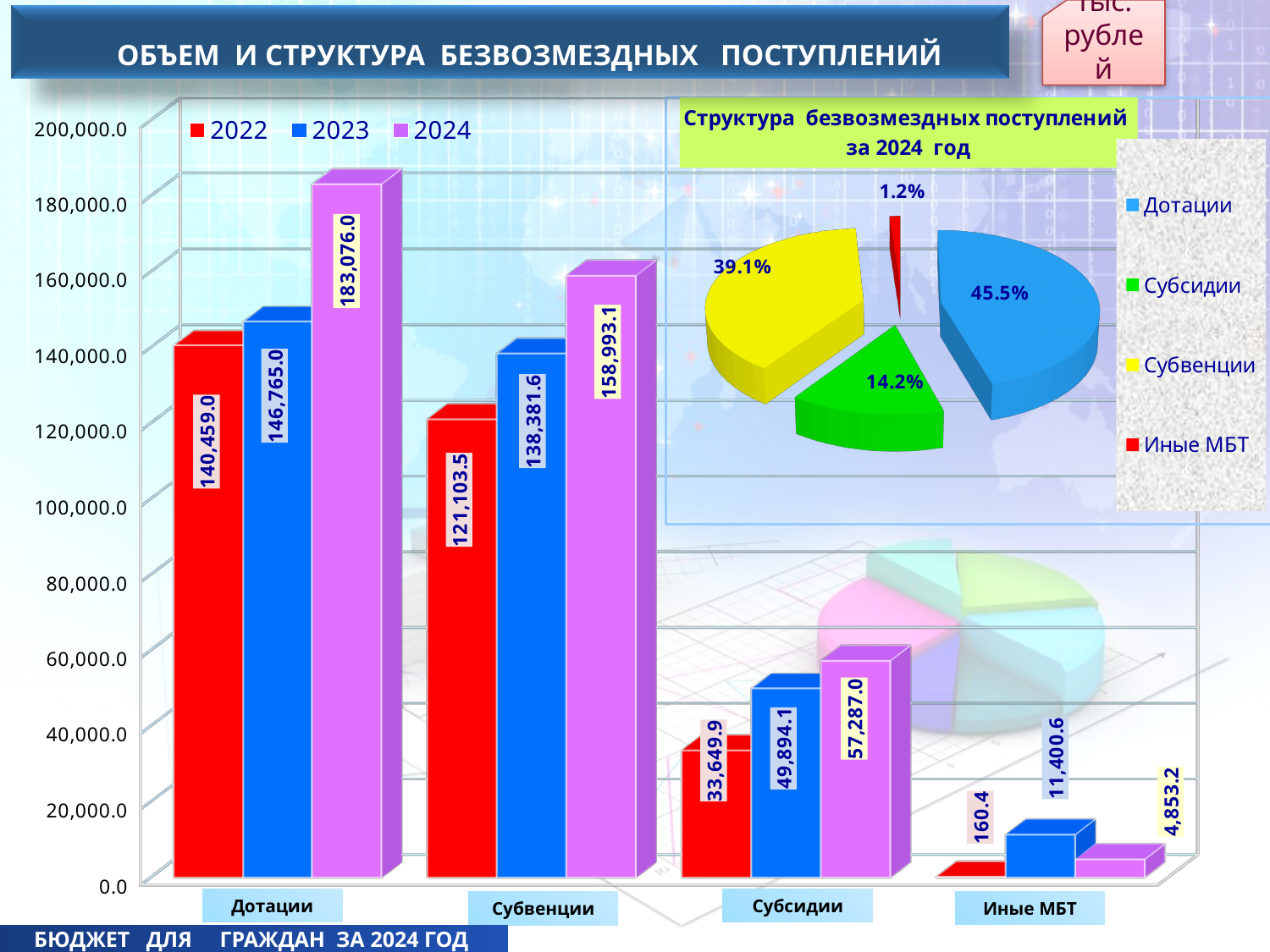
In the bar chart, which category has the lowest value in 2022? Иные МБТ In the bar chart, how many categories are shown on the x axis? 4 In the bar chart, what is the value for Иные МБТ in 2023? 11,400.6 In the bar chart, how many series does the legend list? 3 In the bar chart, what is the difference between the 2024 and 2023 values for Субсидии? 7,392.9 In the bar chart, do the values for Субвенции rise or fall from 2022 to 2024? rise In the pie chart 'Структура безвозмездных поступлений за 2024 год', which slice is the largest? Дотации In the bar chart, which category has the highest value in 2024? Дотации In the bar chart, what is the value for Дотации in 2024? 183,076.0 In the bar chart, what is the value for Субвенции in 2022? 121,103.5 In the pie chart 'Структура безвозмездных поступлений за 2024 год', what share does Субвенции have? 39.1% In the bar chart, which is larger for Иные МБТ: the 2023 value or the 2024 value? 2023